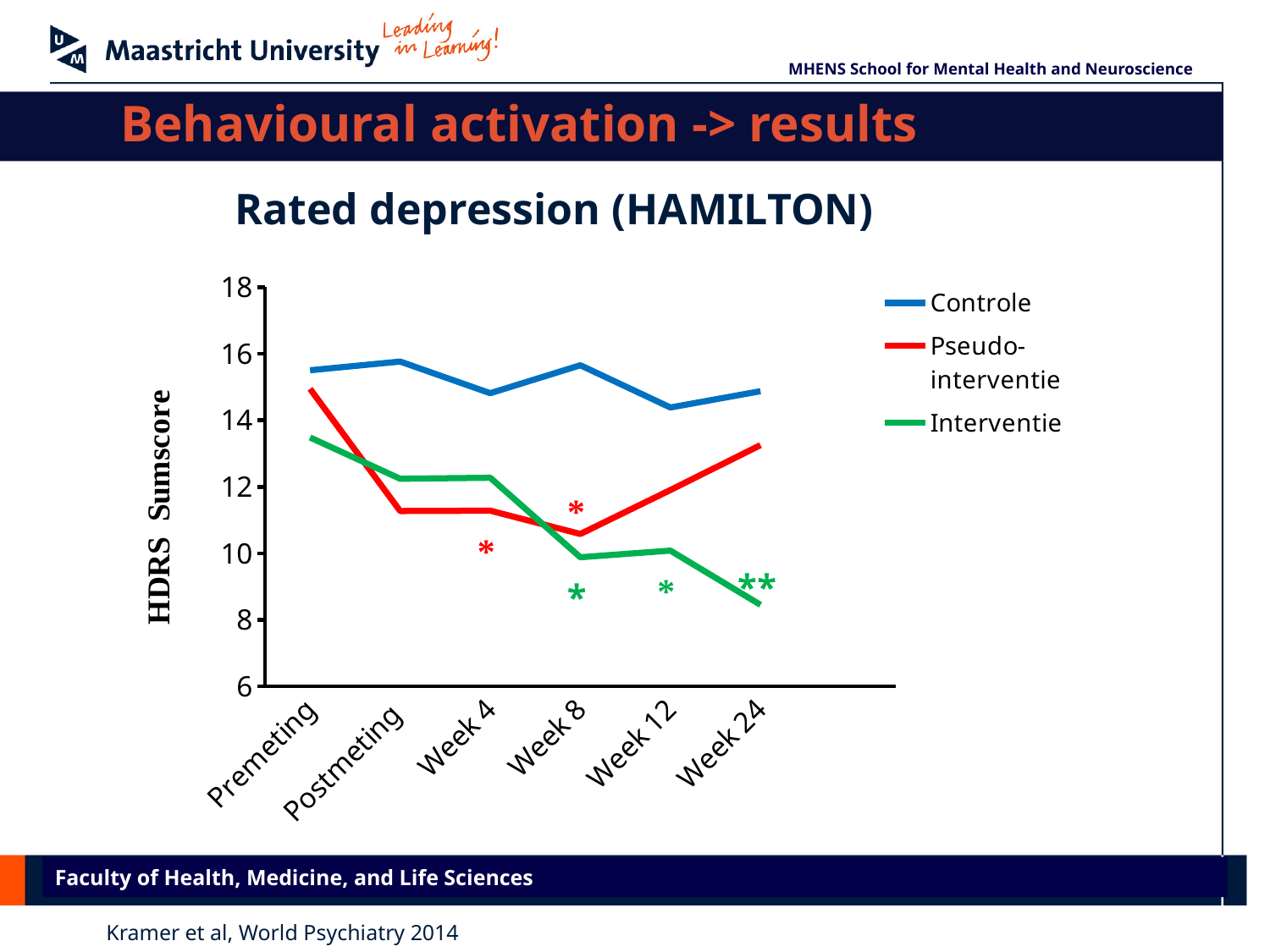
Does the Interventie line rise or fall from Premeting to Week 24? fall Which series has the highest value at Week 8? Controle How many time points are shown along the x axis? 6 What kind of chart is shown on the slide? line chart At Week 24, which series has the larger value: Controle or Interventie? Controle Is the value for Controle at Premeting greater or less than 14? greater At Premeting, which series has the larger value: Pseudo-interventie or Interventie? Pseudo-interventie Is the value for Interventie at Week 24 greater or less than 10? less Is the value for Controle at Week 12 greater or less than 12? greater How many series does the legend list? 3 Which series has the lowest value at Week 24? Interventie